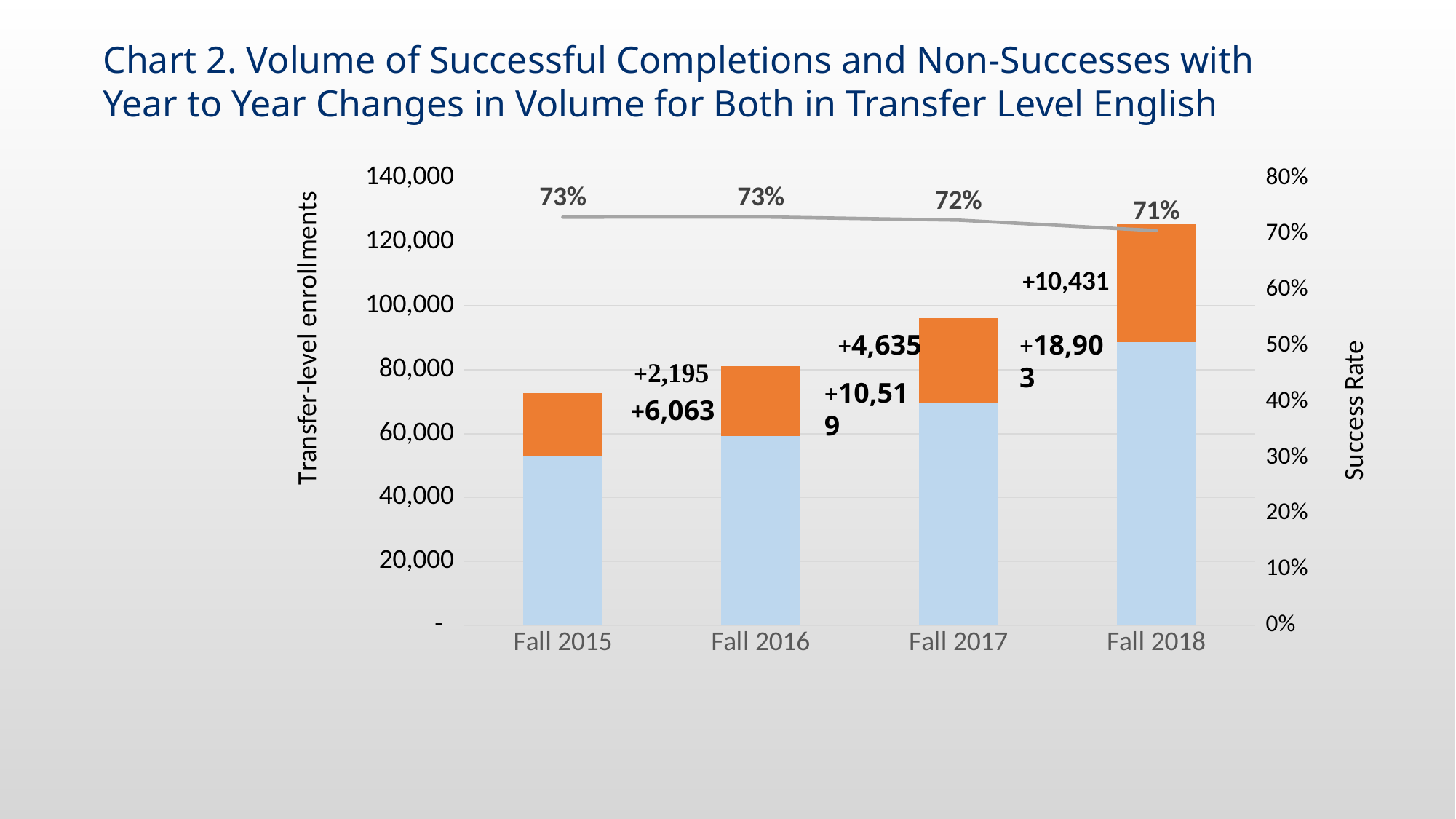
Is the total transfer-level enrollment bar for Fall 2018 greater or less than 120,000? greater What is the success rate shown for Fall 2018? 71% What kind of chart is used to show the transfer-level enrollments? bar chart What is the success rate shown for Fall 2015? 73% How many fall terms are shown on the x axis? 4 Is the total transfer-level enrollment bar for Fall 2015 greater or less than 80,000? less Which fall term has the lowest total transfer-level enrollments? Fall 2015 Does the success rate line rise or fall from Fall 2015 to Fall 2018? fall By how many percentage points did the success rate drop from Fall 2015 to Fall 2018? 2 percentage points What is the title of the right-hand vertical axis? Success Rate Which fall term has the highest total transfer-level enrollments? Fall 2018 What is the success rate shown for Fall 2017? 72%